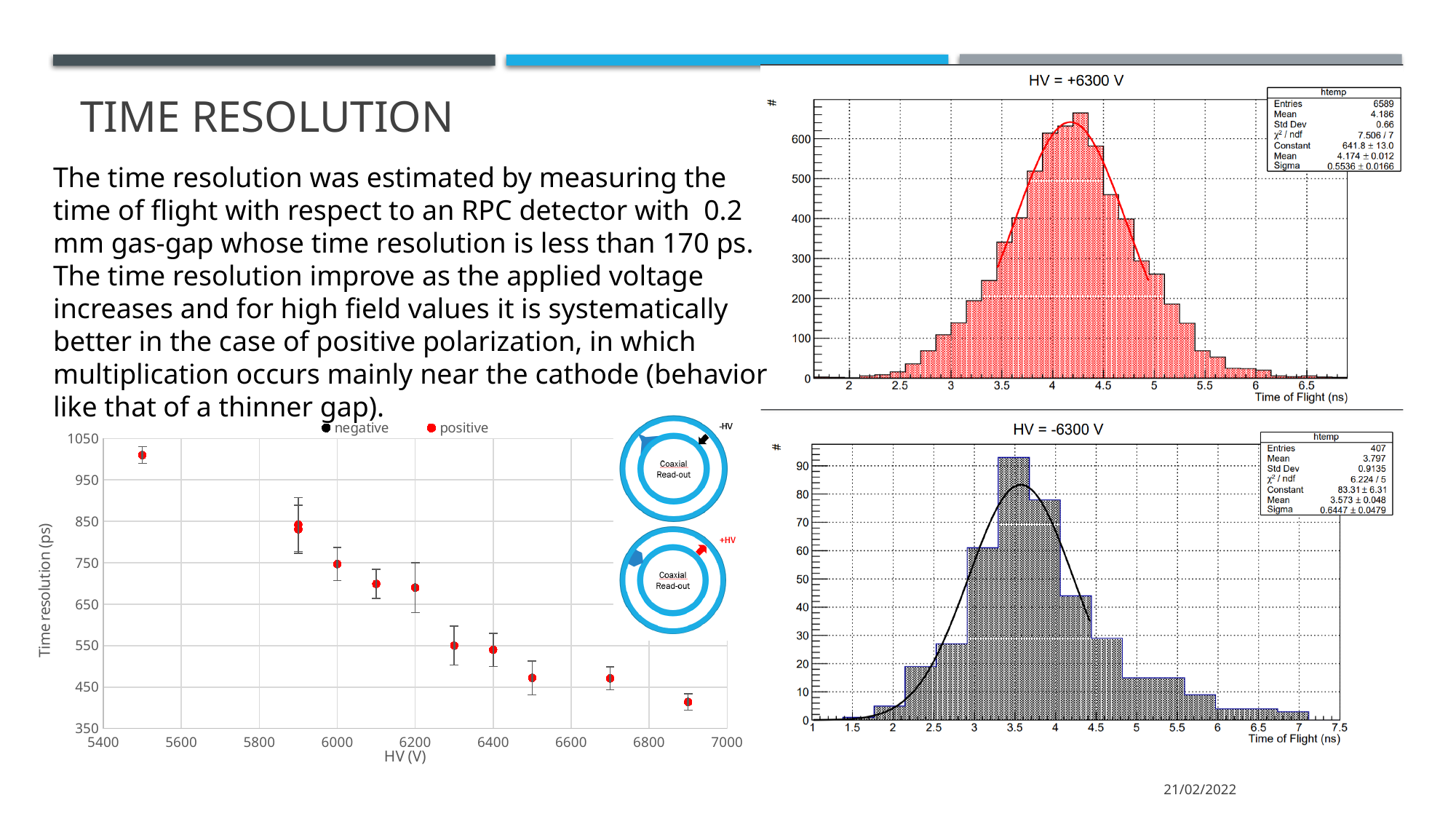
What is the difference in entries between the HV = +6300 V chart and the HV = -6300 V chart? 6182 On the bottom-left chart of time resolution versus HV, is the time resolution at 5500 V greater or less than 950 ps? greater On the bottom-left chart of time resolution versus HV, do the time resolution values rise or fall as HV increases? fall On the bottom-left chart of time resolution versus HV, is the time resolution at 6900 V greater or less than 450 ps? less On the chart titled HV = +6300 V, is the tallest bar greater or less than 600? greater On the chart titled HV = -6300 V, how many entries does the statistics box report? 407 Which chart has more entries, HV = +6300 V or HV = -6300 V? HV = +6300 V On the bottom-left chart of time resolution versus HV, how many series does the legend list? 2 On the chart titled HV = -6300 V, what Std Dev does the statistics box report? 0.9135 On the bottom-left chart of time resolution versus HV, what are the two series named in the legend? negative and positive On the chart titled HV = +6300 V, how many entries does the statistics box report? 6589